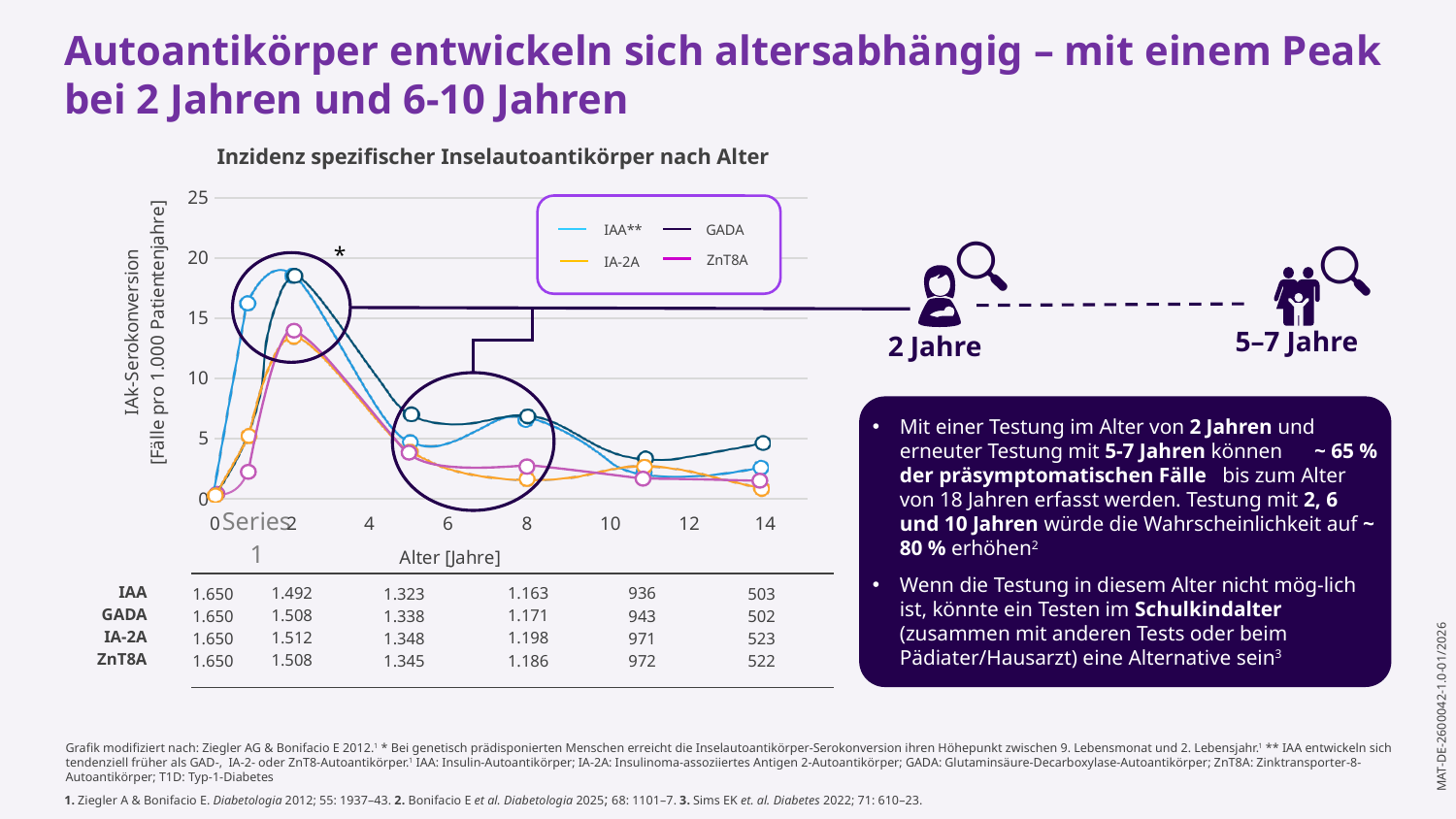
Is the value for GADA at age 2 greater or less than 15? greater What is the label of the x axis of the chart? Alter [Jahre] Does the IAA** line rise or fall between age 2 and age 5? fall Is the value for IAA** at age 14 greater or less than 5? less Is the value for IAA** at age 2 greater or less than 15? greater How many series does the chart legend list? 4 What is the title of the chart? Inzidenz spezifischer Inselautoantikörper nach Alter How many tick marks are labelled on the x axis of the chart? 8 What kind of chart is shown on the slide? line chart